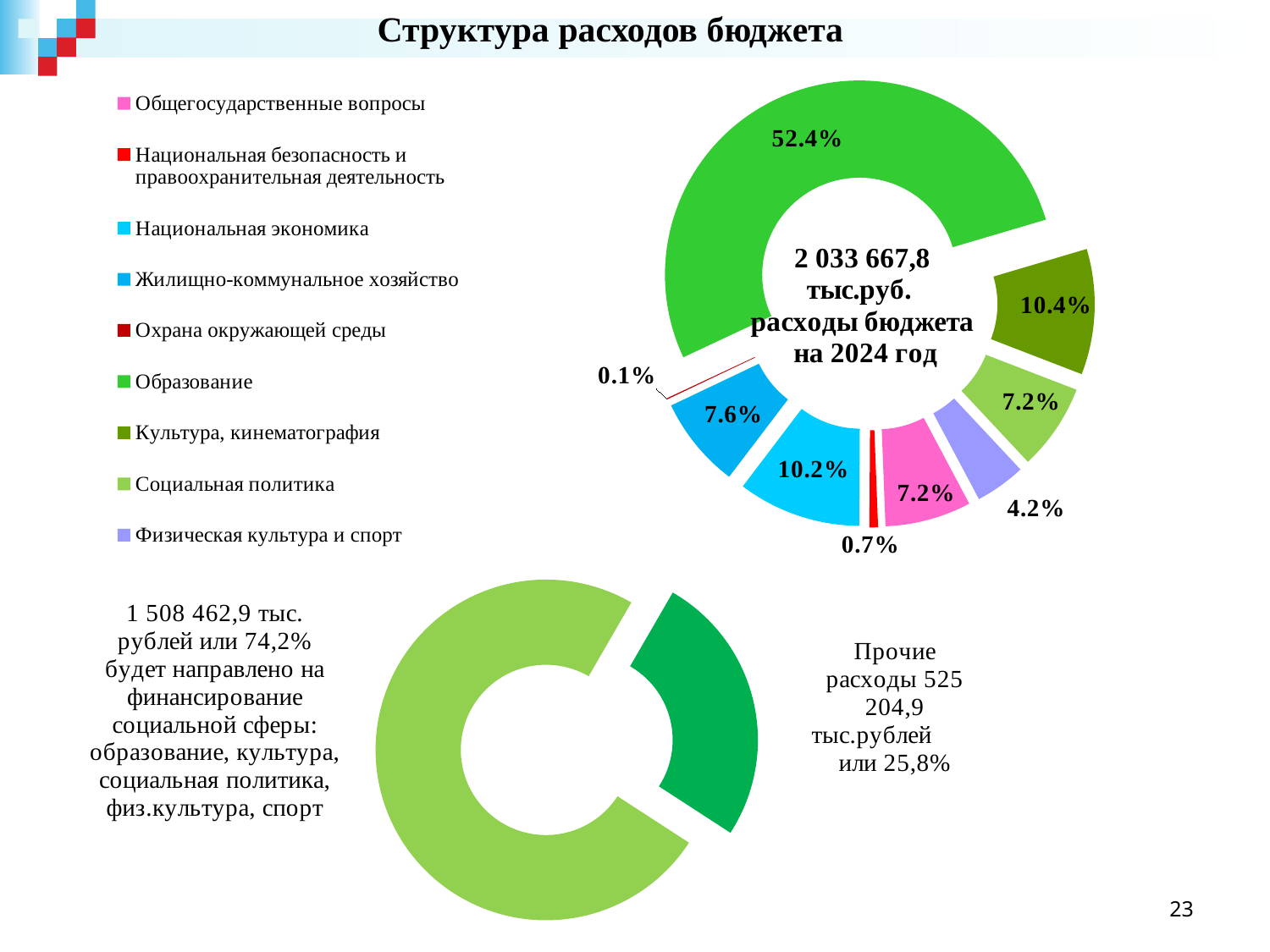
On the top doughnut chart, which category has the smallest share? Охрана окружающей среды On the top doughnut chart, what is the difference in percentage points between Образование and Культура, кинематография? 42 percentage points On the top doughnut chart, what share of budget expenditure goes to Образование? 52.4% What type of chart is shown at the bottom of the slide? Doughnut chart On the top doughnut chart, which category has the largest share? Образование On the top doughnut chart, what percentage is shown for Физическая культура и спорт? 4.2% How many categories does the legend of the top doughnut chart list? 9 On the top doughnut chart, which is larger: the share for Национальная экономика or the share for Жилищно-коммунальное хозяйство? Национальная экономика On the top doughnut chart, what percentage is shown for Национальная экономика? 10.2% On the top doughnut chart, what percentage is shown for Культура, кинематография? 10.4% On the bottom doughnut chart, what share of expenditure is directed to the social sphere? 74,2% What total budget expenditure for 2024 is written in the centre of the top doughnut chart? 2 033 667,8 тыс.руб.